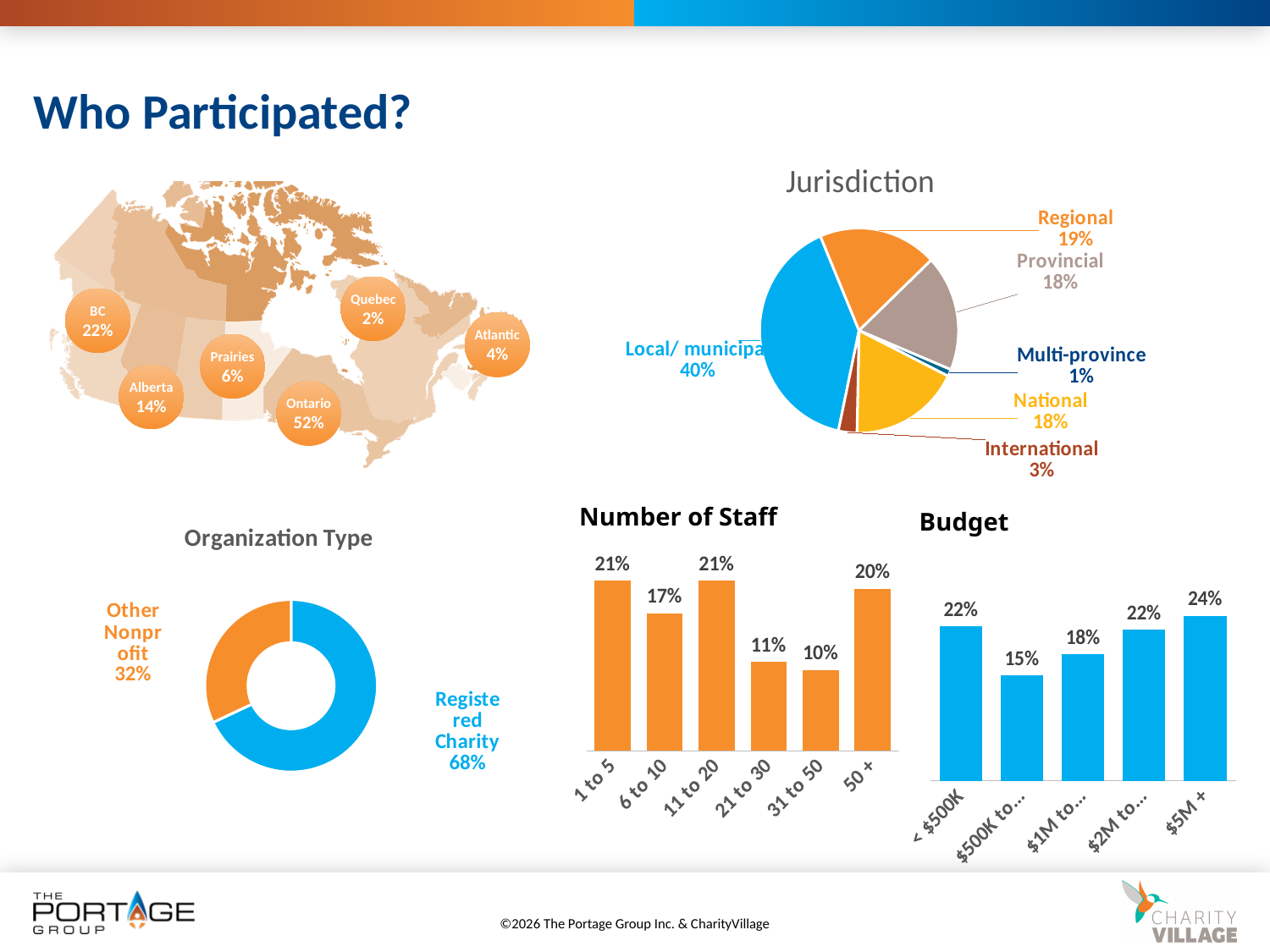
In the Organization Type chart, what share is Registered Charity? 68% In the Jurisdiction pie chart, which jurisdiction has the smallest share? Multi-province What kind of chart is the Budget chart? Bar chart In the Budget bar chart, what is the value for < $500K? 22% In the Budget bar chart, which category has the highest value? $5M + How many categories are shown in the Number of Staff bar chart? 6 In the Number of Staff bar chart, what is the value for 6 to 10? 17% What kind of chart is the Organization Type chart? Donut chart In the Jurisdiction pie chart, what share is Local/municipal? 40% How many slices does the Jurisdiction pie chart have? 6 In the Jurisdiction pie chart, what is the difference between the Regional and International shares? 16% In the Number of Staff bar chart, which category has the lowest value? 31 to 50